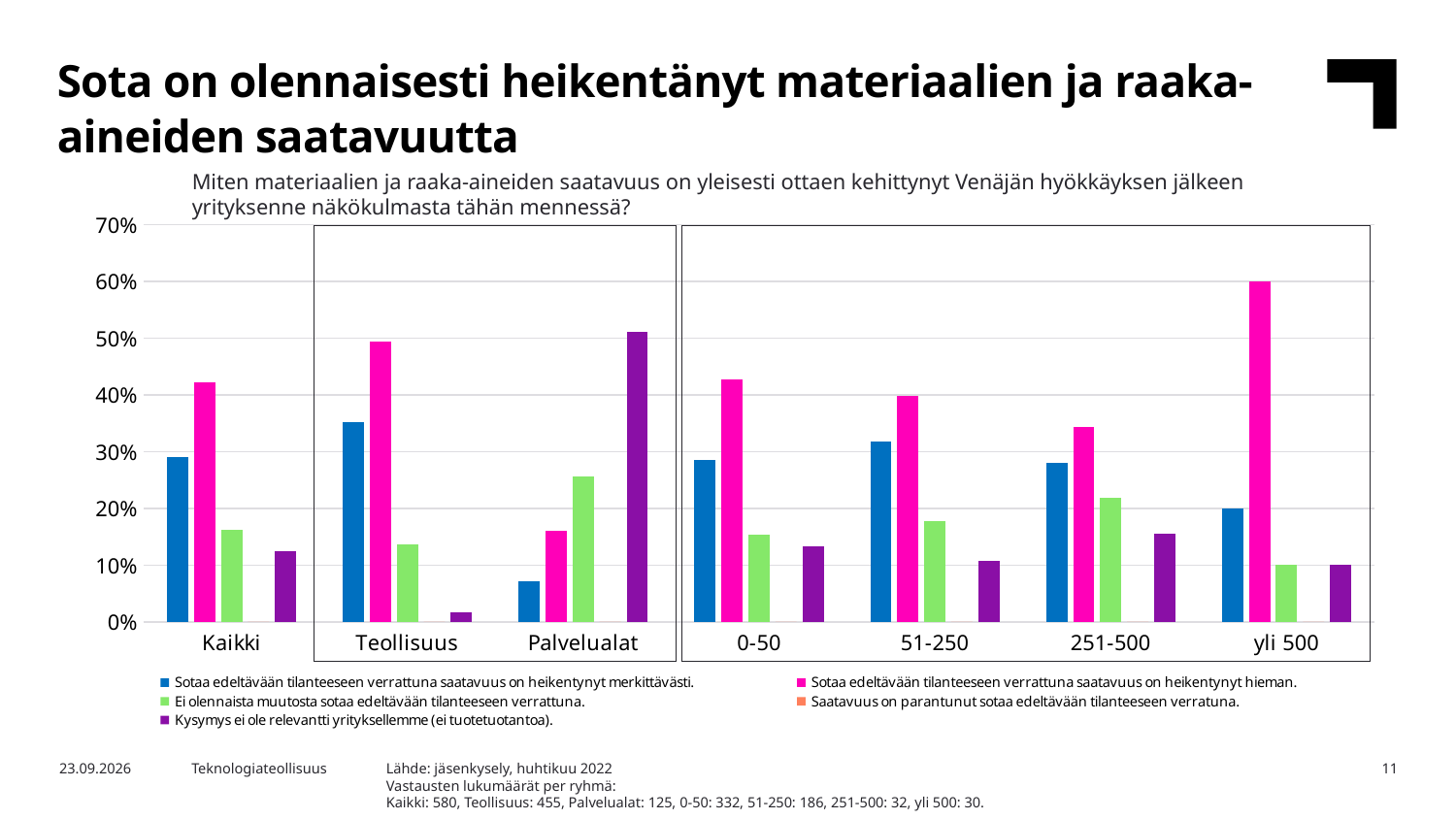
Is the value of 'Sotaa edeltävään tilanteeseen verrattuna saatavuus on heikentynyt hieman' for 'yli 500' greater or less than 50%? greater Is the value of 'Kysymys ei ole relevantti yrityksellemme (ei tuotetuotantoa)' for 'Palvelualat' greater or less than 40%? greater Which category has the highest value for 'Sotaa edeltävään tilanteeseen verrattuna saatavuus on heikentynyt hieman'? yli 500 How many categories are shown along the x axis of the chart? 7 What kind of chart is shown on the slide? bar chart Is the value of 'Ei olennaista muutosta sotaa edeltävään tilanteeseen verrattuna' for 'Kaikki' greater or less than 20%? less How many series does the chart's legend list? 5 Which category has the highest value for 'Kysymys ei ole relevantti yrityksellemme (ei tuotetuotantoa)'? Palvelualat Which category has the lowest value for 'Sotaa edeltävään tilanteeseen verrattuna saatavuus on heikentynyt merkittävästi'? Palvelualat For 'Kaikki', which is larger: 'saatavuus on heikentynyt merkittävästi' or 'saatavuus on heikentynyt hieman'? saatavuus on heikentynyt hieman What colour represents 'Kysymys ei ole relevantti yrityksellemme (ei tuotetuotantoa)' in the chart? purple